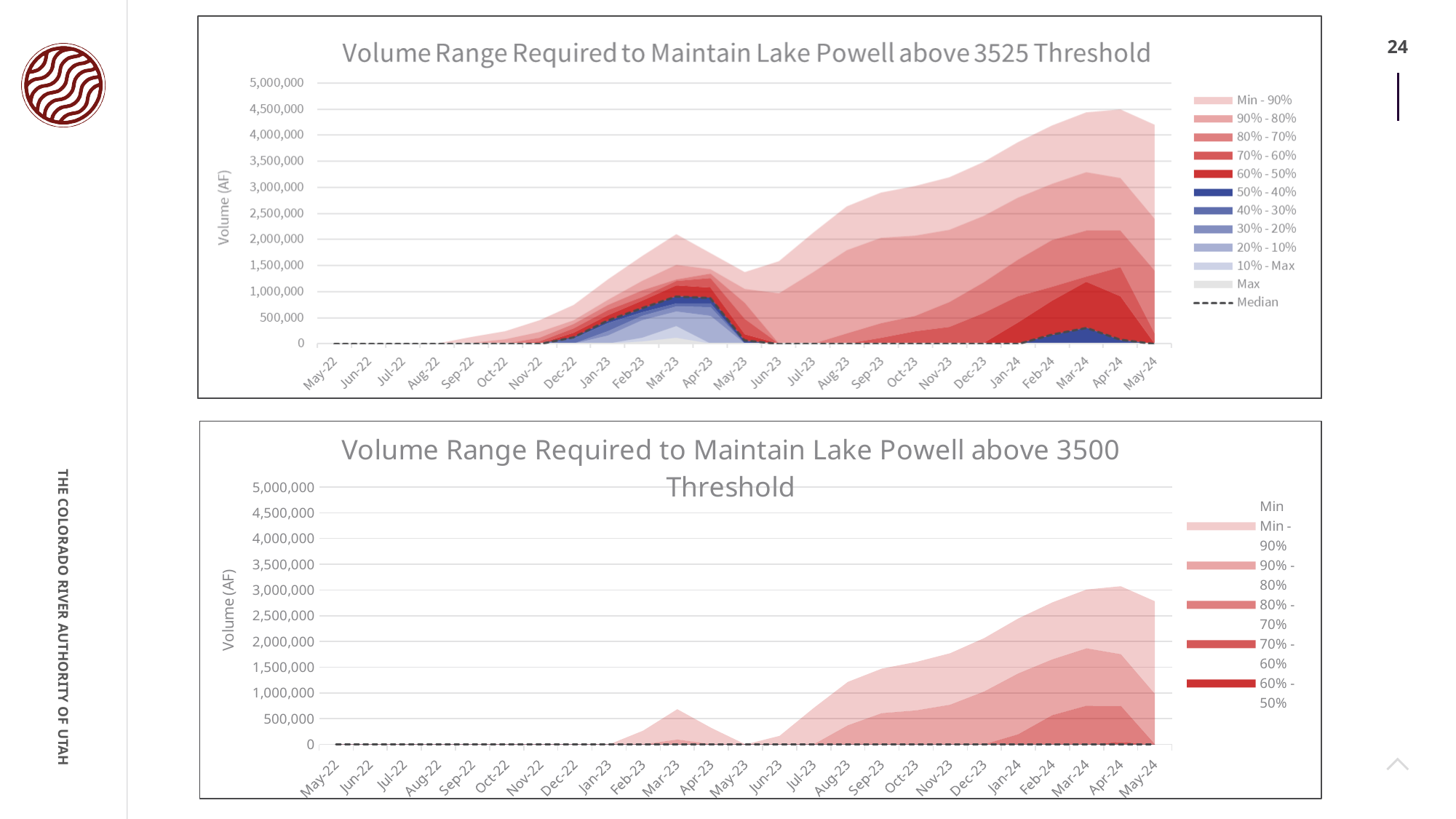
In the top chart (3525 Threshold), is the top of the outer 'Min - 90%' band at Apr-24 greater or less than 4,000,000? greater In the top chart (3525 Threshold), how many entries does the legend list? 12 In the top chart (3525 Threshold), in which month does the outer 'Min - 90%' band reach its highest value? Apr-24 In the top chart (3525 Threshold), is the top of the outer 'Min - 90%' band at Mar-23 greater or less than 1,500,000? greater In the top chart (3525 Threshold), does the top of the outer band rise or fall from Jan-24 to Apr-24? Rise What kind of chart is the top chart, 'Volume Range Required to Maintain Lake Powell above 3525 Threshold'? Area chart In the top chart (3525 Threshold), what is the highest value shown on the y axis? 5,000,000 In the top chart (3525 Threshold), how many months are shown along the x axis? 25 In the bottom chart (3500 Threshold), is the top of the outer 'Min - 90%' band at Mar-23 greater or less than 1,000,000? less What is the title of the bottom chart? Volume Range Required to Maintain Lake Powell above 3500 Threshold In the top chart (3525 Threshold), is the top of the outer band higher at Apr-24 or at Mar-23? Apr-24